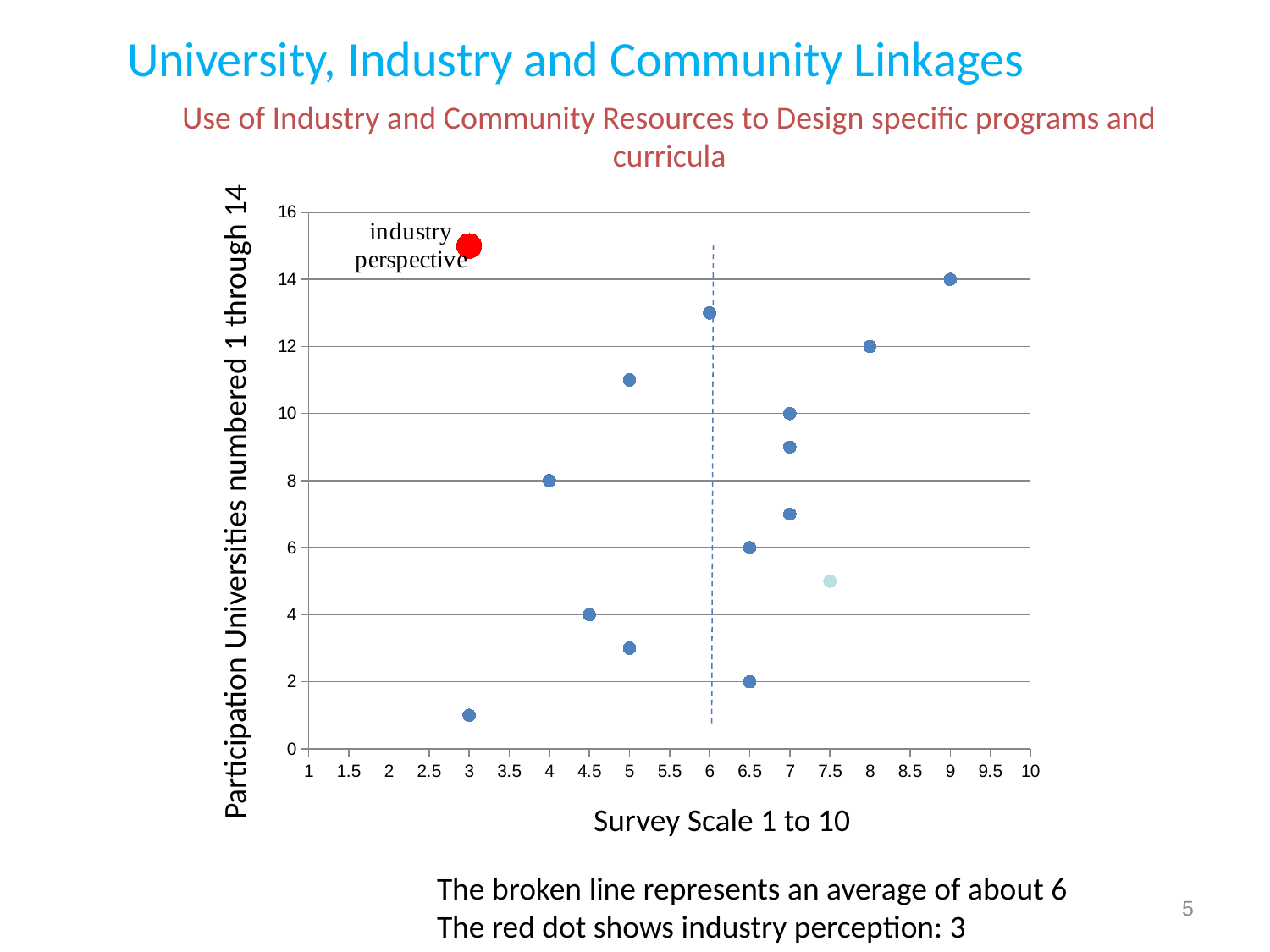
What kind of chart is shown on the slide? scatter chart What survey score is plotted for university 6? 6.5 What is the highest survey score plotted for any university? 9 What is the lowest survey score plotted for any university? 3 What survey score is plotted for university 12? 8 What survey score is plotted for university 4? 4.5 What survey score does the red dot (industry perspective) show? 3 What is the difference between the survey scores of university 14 and university 8? 5 What survey score is plotted for university 8? 4 Which has the higher survey score, university 14 or university 12? university 14 Is the survey score for university 10 greater or less than 6? greater What survey score is plotted for university 14? 9